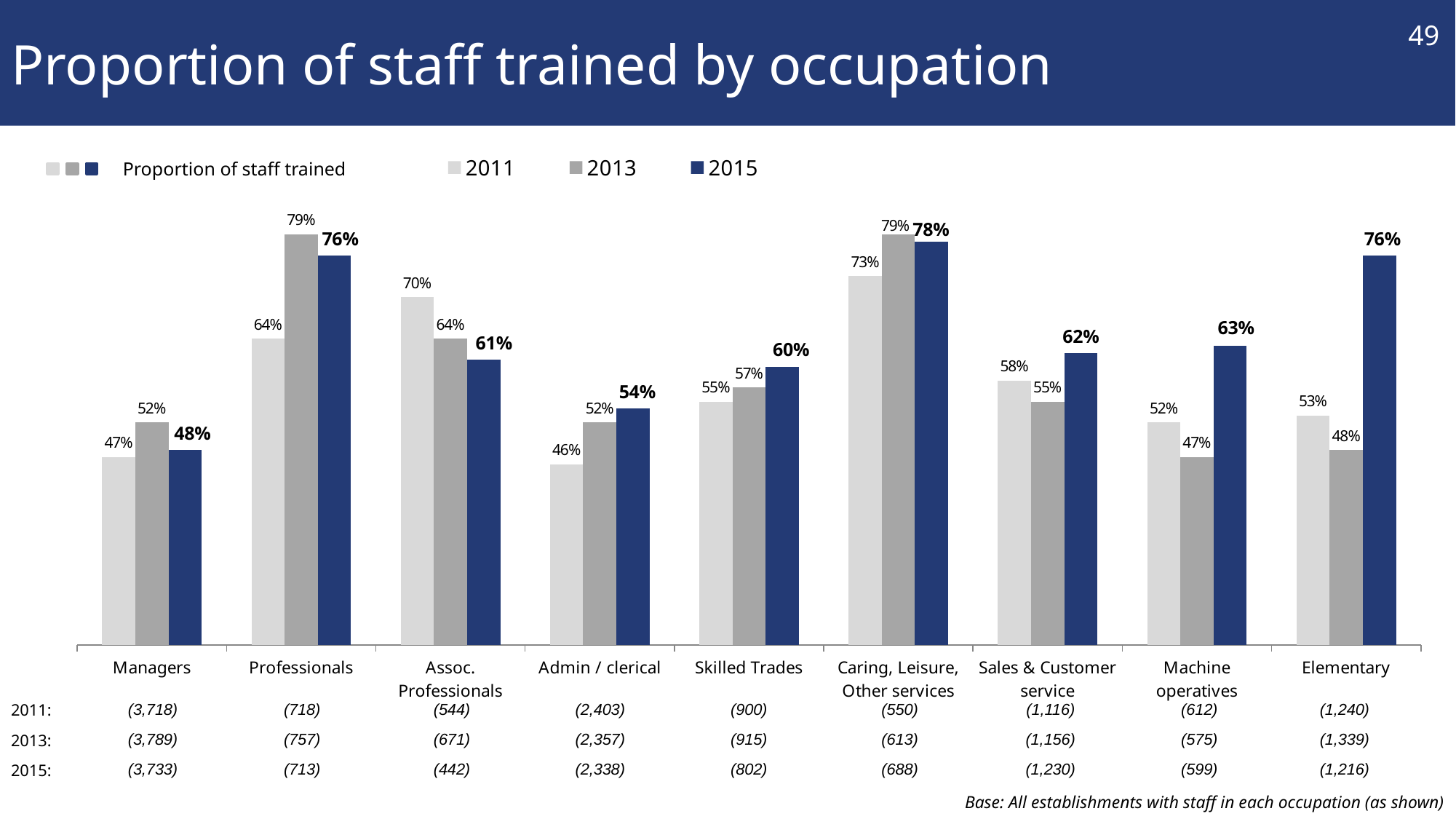
What is the 2015 base (number of establishments) for Sales & Customer service? (1,230) How many series does the legend list? 3 What is the proportion of staff trained for Managers in 2015? 48% Which is larger for Professionals: the 2013 value or the 2015 value? 2013 Which occupation has the lowest proportion of staff trained in 2015? Managers What is the proportion of staff trained for Admin / clerical in 2011? 46% What is the proportion of staff trained for Elementary in 2013? 48% Do the values for Machine operatives rise or fall from 2013 to 2015? Rise What is the difference between the 2015 and 2013 values for Elementary? 28 percentage points What kind of chart is shown on the slide? Bar chart Which occupation has the highest proportion of staff trained in 2015? Caring, Leisure, Other services How many occupation categories are shown on the x axis? 9